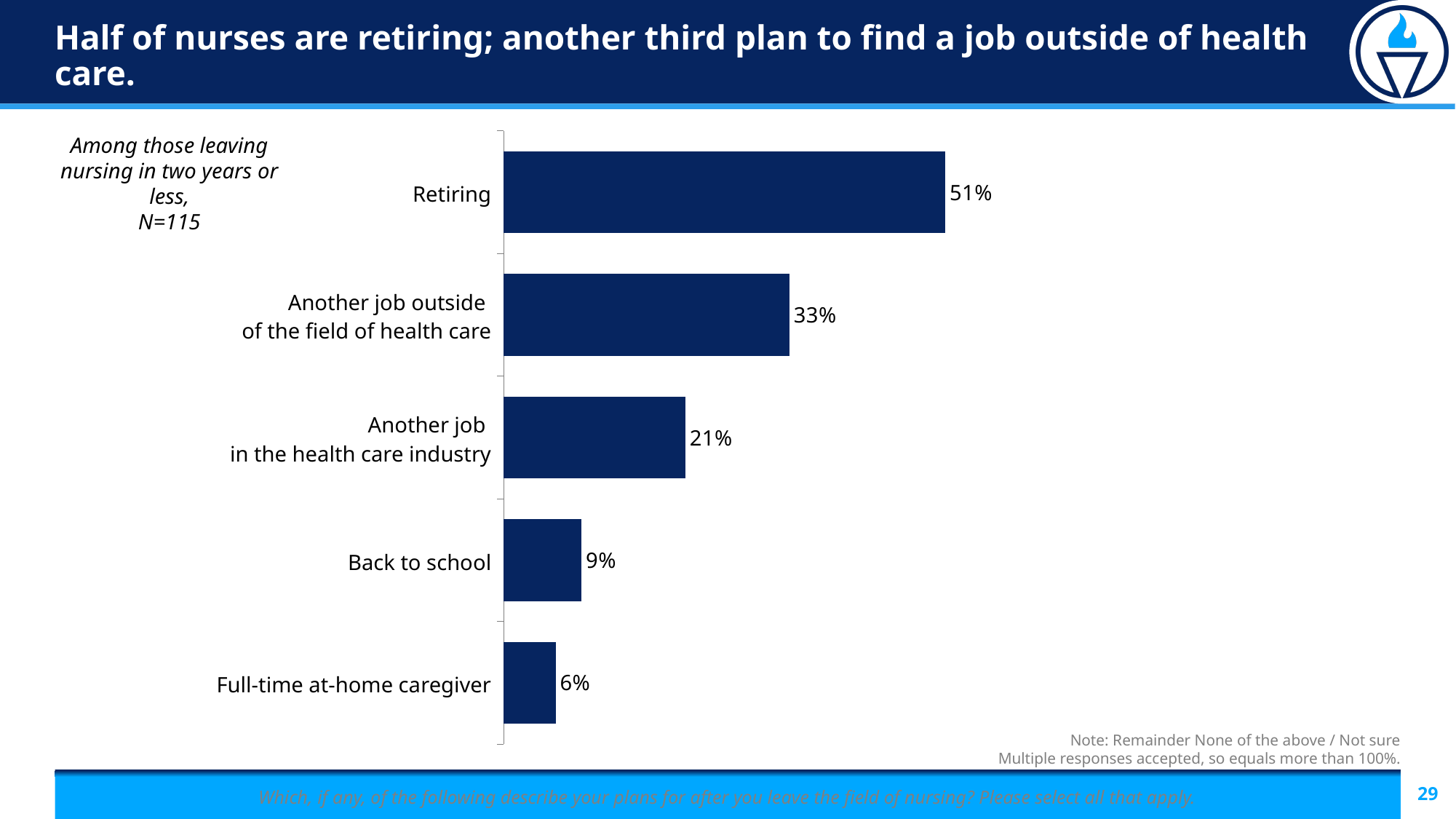
What is the difference between the 'Retiring' value and the 'Another job outside of the field of health care' value? 18 percentage points How many categories are shown in the chart? 5 Which category has the lowest value? Full-time at-home caregiver What is the value for 'Back to school'? 9% What is the sample size (N) noted for the chart? N=115 What type of chart is shown on the slide? Bar chart Which is larger: 'Another job in the health care industry' or 'Back to school'? Another job in the health care industry What percentage plan to take another job in the health care industry? 21% What percentage plan to become a full-time at-home caregiver? 6% Which category has the highest value? Retiring What percentage of nurses leaving nursing say they are retiring? 51% What is the value for 'Another job outside of the field of health care'? 33%